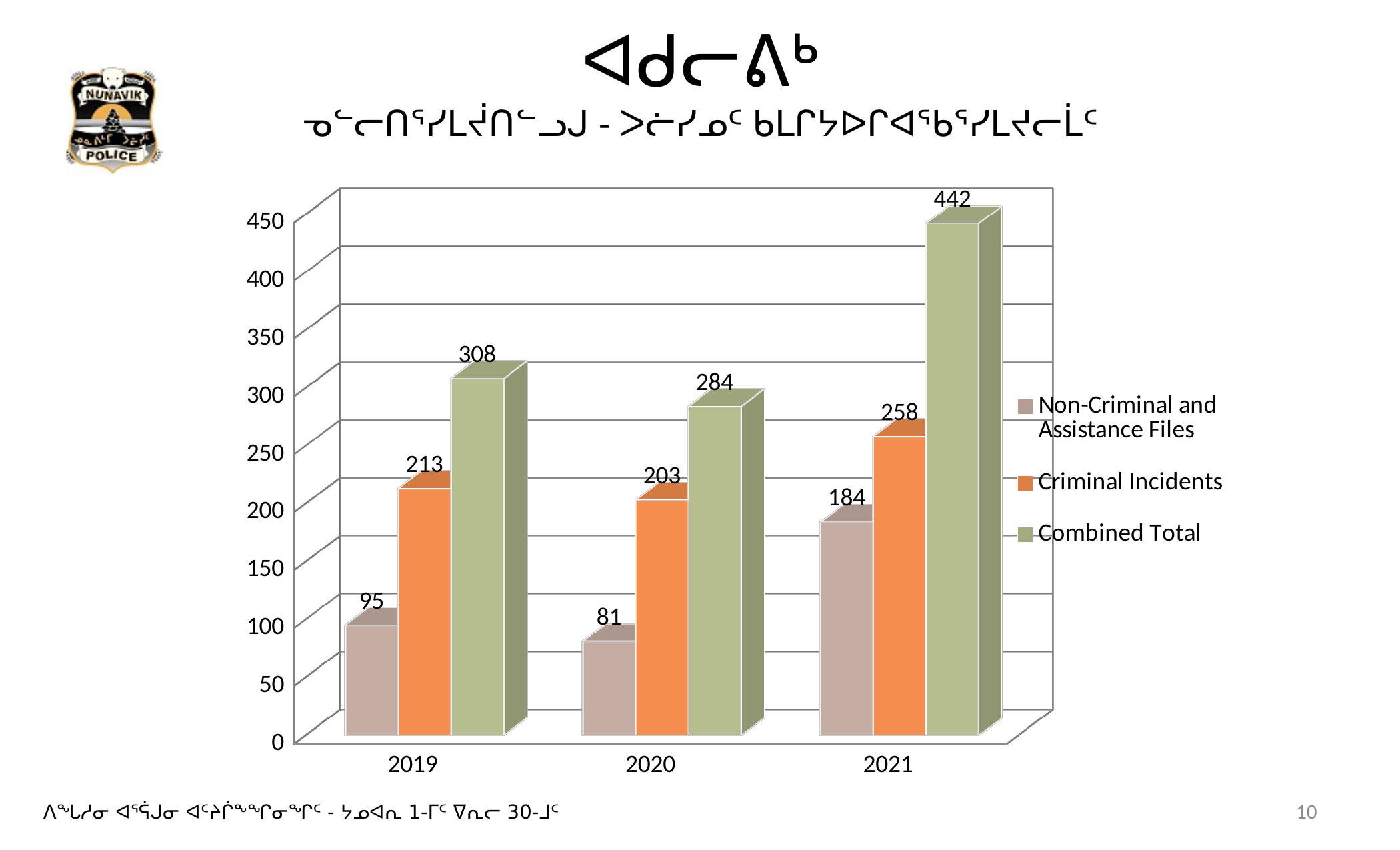
Is the Combined Total for 2020 greater or less than 250? greater Does the Criminal Incidents series rise or fall from 2020 to 2021? rise Which is larger: Criminal Incidents in 2019 or Criminal Incidents in 2021? Criminal Incidents in 2021 What is the value for Non-Criminal and Assistance Files in 2021? 184 How many years are shown on the x axis? 3 What is the Combined Total for 2019? 308 Which year has the lowest value for Non-Criminal and Assistance Files? 2020 What is the difference between the Combined Total in 2021 and in 2020? 158 What is the value for Criminal Incidents in 2020? 203 How many series does the legend list? 3 Which year has the highest Combined Total? 2021 What kind of chart is shown on the slide? bar chart